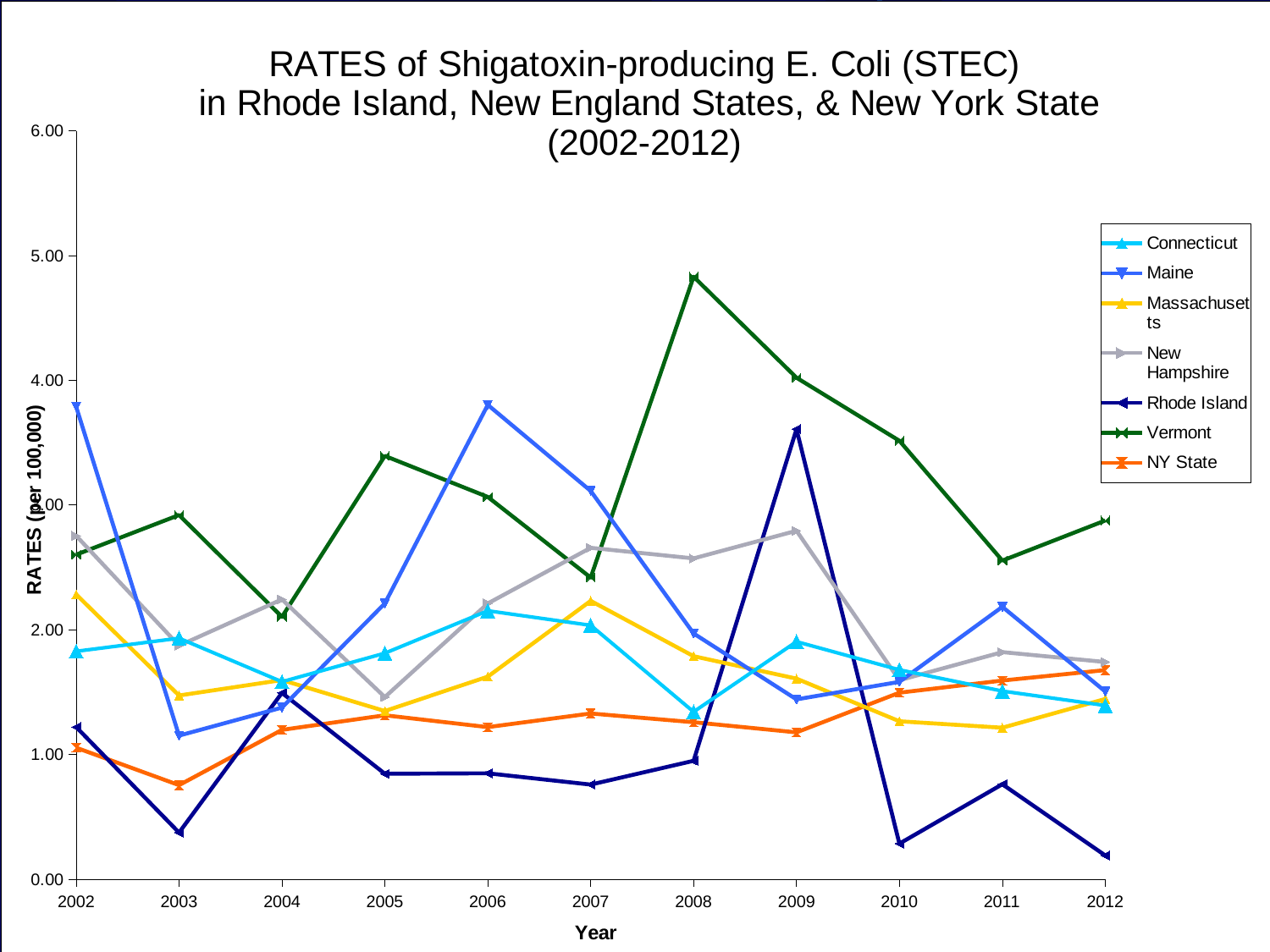
Is the value for Vermont in 2008 greater or less than 4.00? greater What is the label on the y axis? RATES (per 100,000) How many series does the legend list? 7 Does the rate for Vermont rise or fall from 2008 to 2011? fall In 2009, which is larger, the rate for Rhode Island or the rate for Maine? Rhode Island Is the value for Rhode Island in 2003 greater or less than 1.00? less Is the value for Maine in 2006 greater or less than 3.00? greater How many years are plotted along the x axis? 11 What kind of chart is shown on the slide? line chart Which state has the highest rate in 2002? Maine Which state has the lowest rate in 2012? Rhode Island Which state has the highest rate in 2008? Vermont